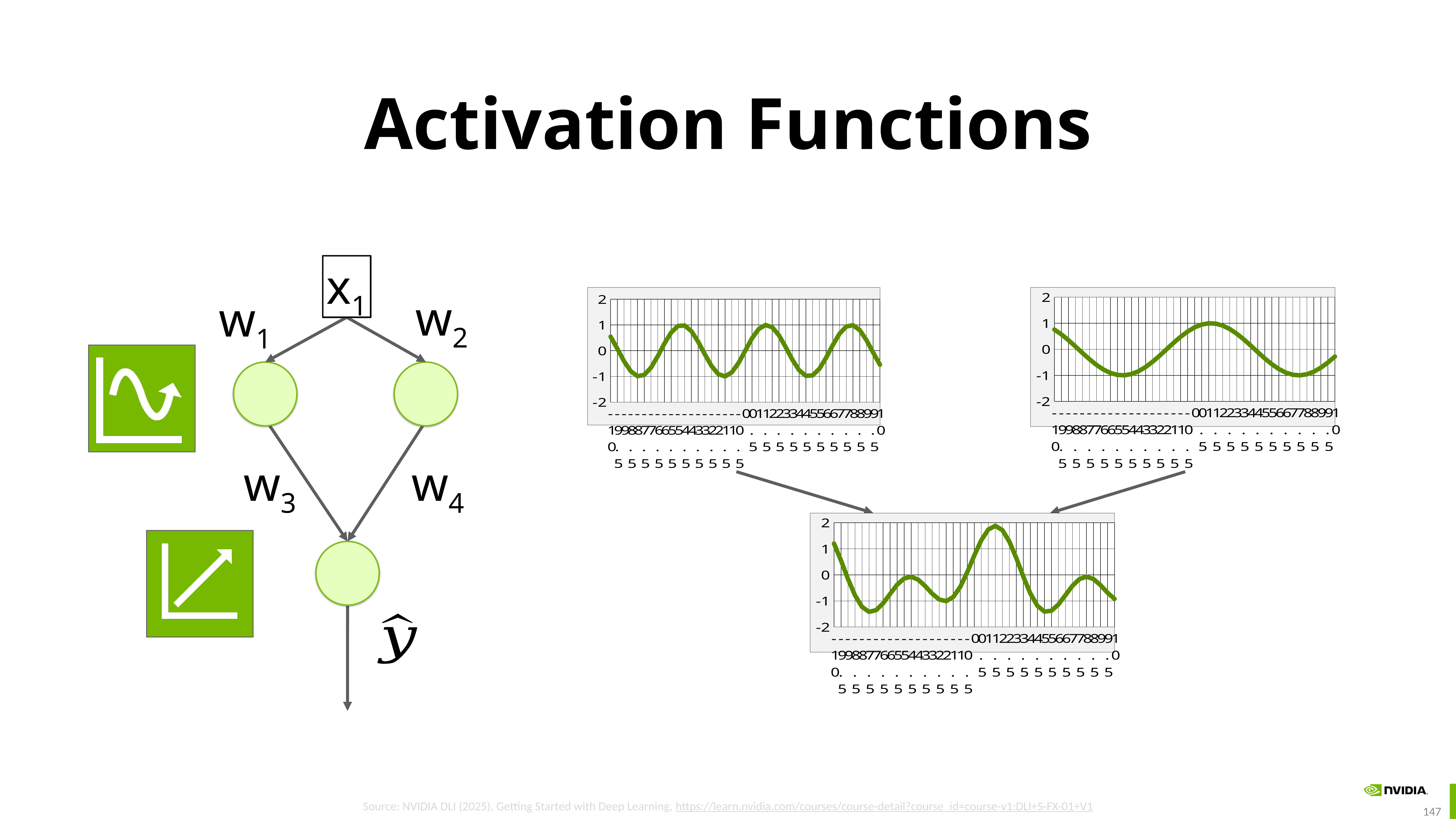
On the bottom chart, is the lowest point of the line greater or less than -1? less On the top-left chart, is the lowest point of the line greater or less than -2? greater On the top-right chart, is the highest point of the line greater or less than 2? less On the top-left chart, what is the highest value shown on the y axis? 2 On the top-right chart, how many peaks does the line reach? 1 What kind of chart is the top-left chart on the slide? line chart On the top-left chart, how many peaks does the line reach? 3 Which chart shows more oscillations of the line, the top-left chart or the top-right chart? top-left chart On the bottom chart, what is the lowest value shown on the y axis? -2 How many charts are shown on the slide? 3